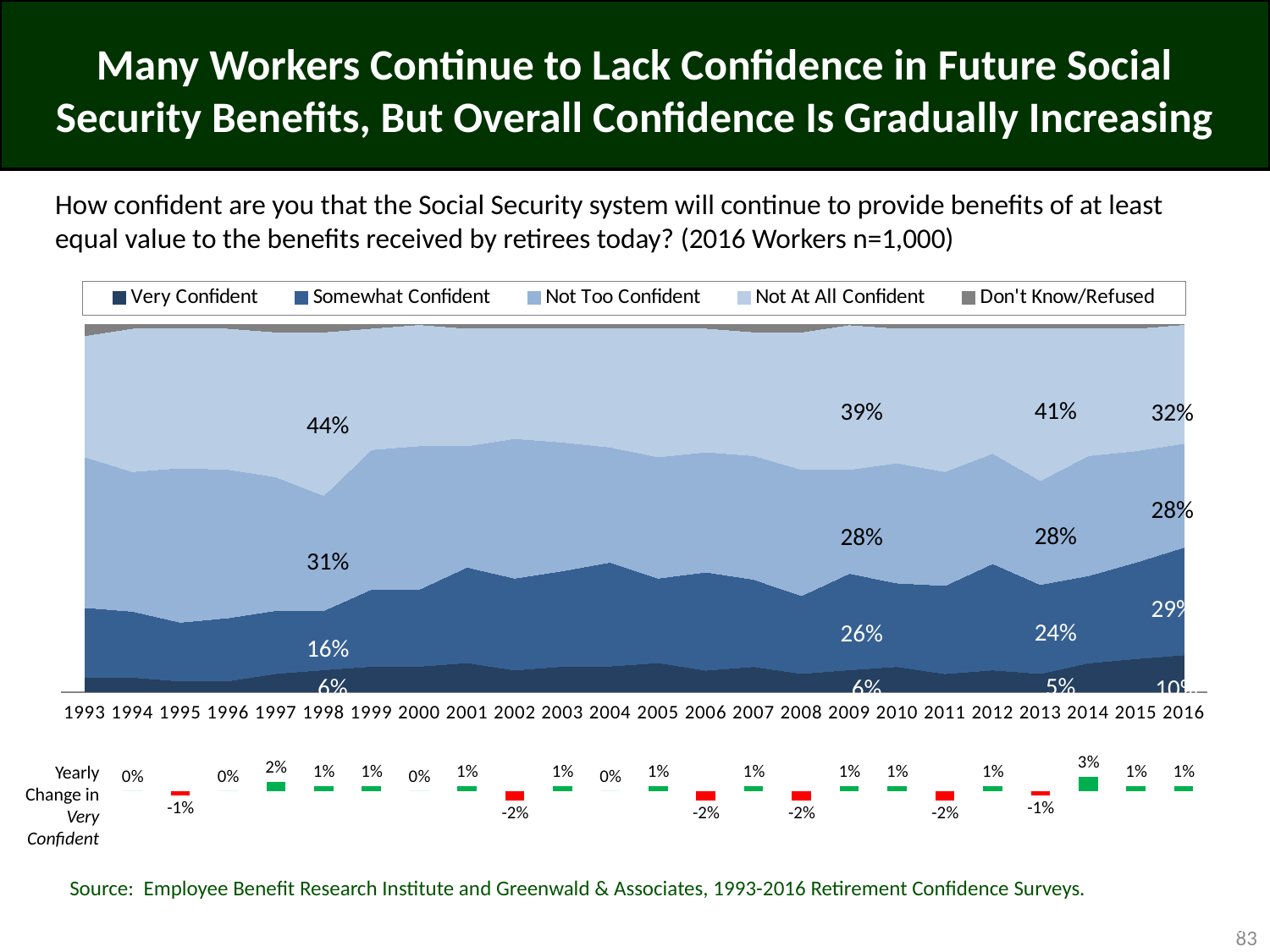
How many series does the legend of the main chart list? 5 In the main chart, which is larger in 2016: the Somewhat Confident share or the Not Too Confident share? Somewhat Confident In the Yearly Change in Very Confident chart, what is the lowest yearly change shown? -2% In the main chart, what percentage of workers were Very Confident in 2016? 10% In the main chart, what is the total of the four labelled values shown for 2009? 99% What kind of chart is the main chart showing confidence levels from 1993 to 2016? Stacked area chart In the main chart, what is the difference between the Not At All Confident share in 2013 and in 2016? 9% What kind of chart is the Yearly Change in Very Confident chart at the bottom of the slide? Bar chart In the main chart, what percentage of workers were Not At All Confident in 1998? 44% In the main chart, what percentage of workers were Not Too Confident in 2009? 28% In the main chart, what percentage of workers were Somewhat Confident in 2013? 24% In the Yearly Change in Very Confident chart, what is the largest yearly change shown? 3%